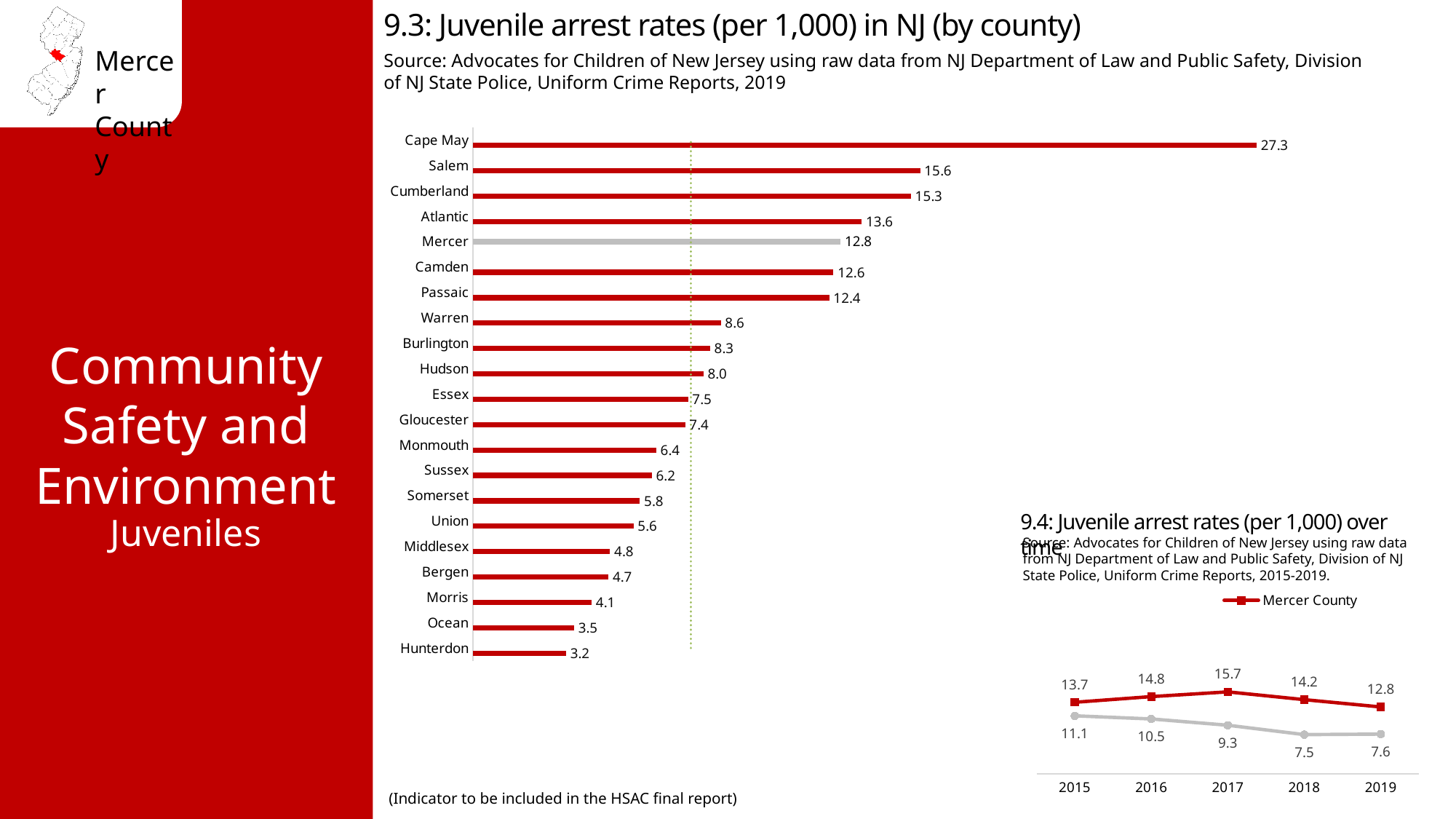
In chart 9.3 (juvenile arrest rates by county), how many counties are shown? 21 In chart 9.4 (juvenile arrest rates over time), what is the Mercer County value for 2017? 15.7 In chart 9.4 (juvenile arrest rates over time), what is the difference between the Mercer County values for 2017 and 2019? 2.9 In chart 9.3 (juvenile arrest rates by county), which county has the lowest rate? Hunterdon In chart 9.4 (juvenile arrest rates over time), in which year is the Mercer County value highest? 2017 In chart 9.3 (juvenile arrest rates by county), what is the value for Passaic? 12.4 In chart 9.3 (juvenile arrest rates by county), which county has the highest rate? Cape May What kind of chart is chart 9.3 (juvenile arrest rates by county)? Bar chart In chart 9.3 (juvenile arrest rates by county), which is larger, the value for Atlantic or the value for Camden? Atlantic In chart 9.3 (juvenile arrest rates by county), what is the difference between Cape May and Salem? 11.7 In chart 9.3 (juvenile arrest rates by county), what is the value for Mercer? 12.8 In chart 9.4 (juvenile arrest rates over time), how many years are shown on the x axis? 5